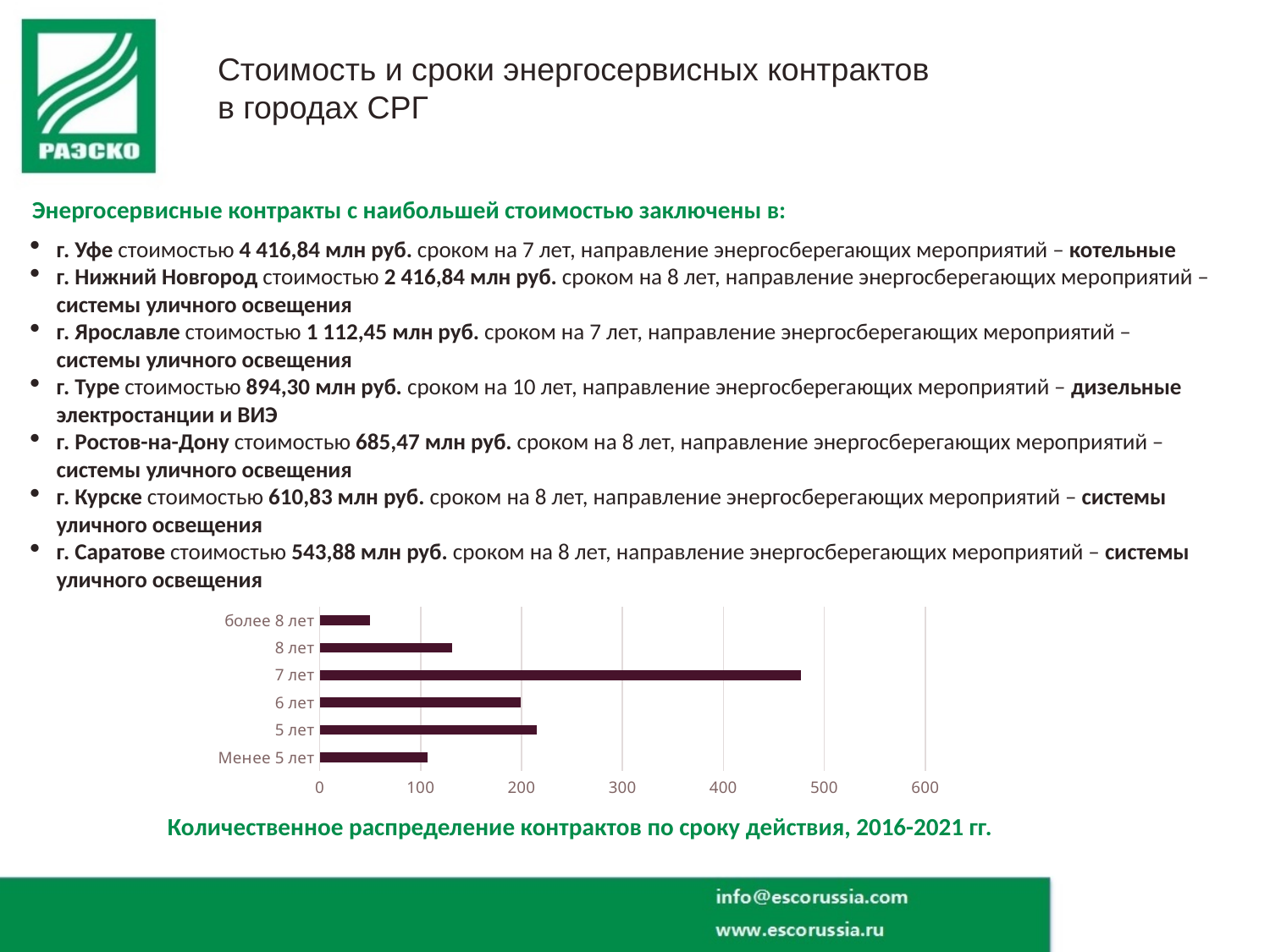
Which contract duration category has the lowest number of contracts? более 8 лет Is the value for 8 лет greater or less than 100? greater Is the value for 6 лет greater or less than 300? less Which has more contracts, 7 лет or 8 лет? 7 лет Is the value for 7 лет greater or less than 400? greater How many contract-duration categories does the chart show? 6 Which has more contracts, Менее 5 лет or 6 лет? 6 лет What kind of chart is shown on the slide? bar chart What is the caption of the chart? Количественное распределение контрактов по сроку действия, 2016-2021 гг. Which contract duration category has the highest number of contracts? 7 лет